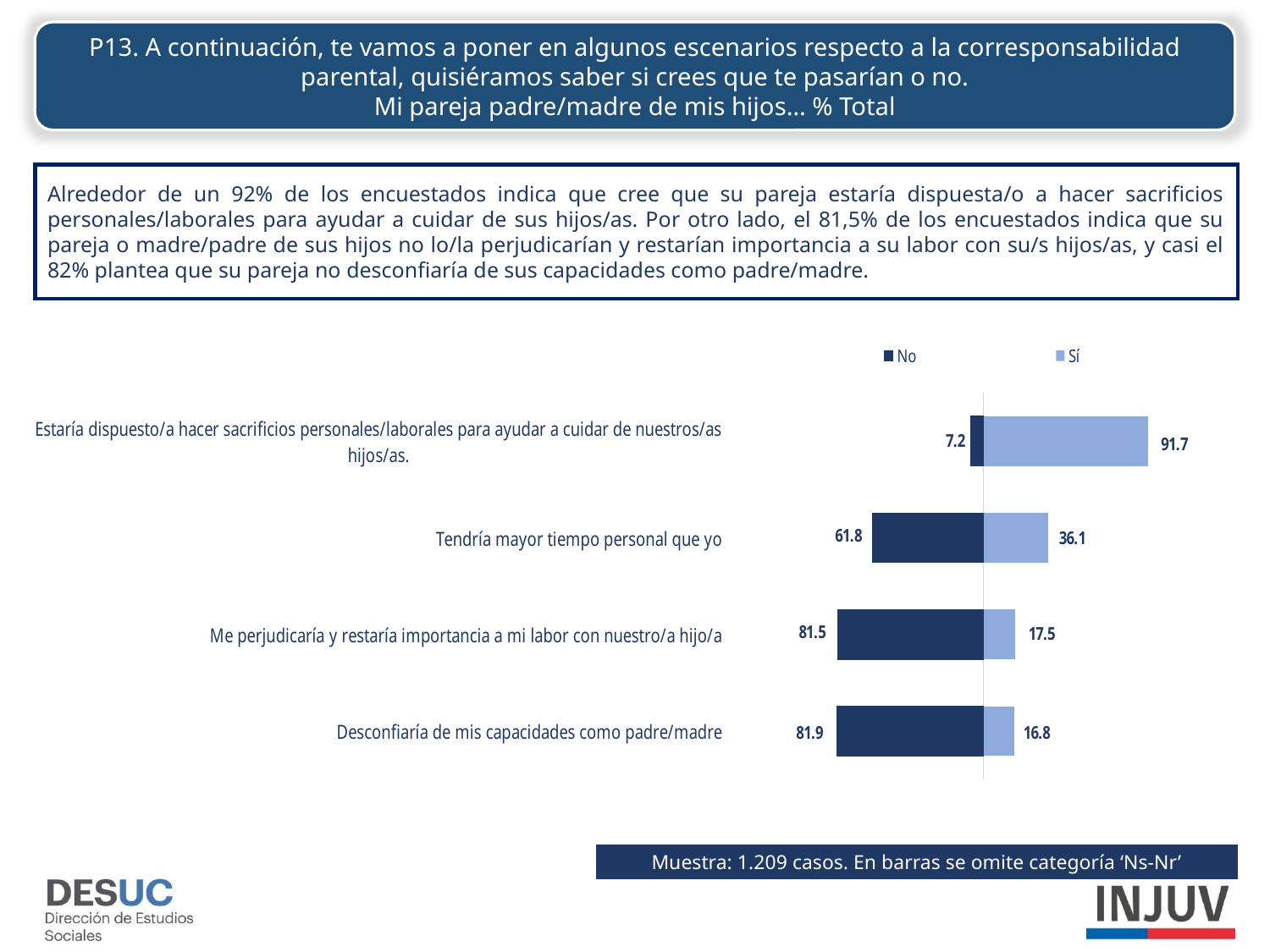
What is the difference between the 'Sí' and 'No' values for 'Estaría dispuesto/a hacer sacrificios personales/laborales para ayudar a cuidar de nuestros/as hijos/as.'? 84.5 Which legend entry is shown in the darker blue colour? No What is the 'Sí' value for 'Me perjudicaría y restaría importancia a mi labor con nuestro/a hijo/a'? 17.5 What is the 'Sí' value for 'Estaría dispuesto/a hacer sacrificios personales/laborales para ayudar a cuidar de nuestros/as hijos/as.'? 91.7 Which statement has the highest 'Sí' value? Estaría dispuesto/a hacer sacrificios personales/laborales para ayudar a cuidar de nuestros/as hijos/as. How many series does the chart legend list? 2 What is the 'No' value for 'Desconfiaría de mis capacidades como padre/madre'? 81.9 Which statement has the lowest 'No' value? Estaría dispuesto/a hacer sacrificios personales/laborales para ayudar a cuidar de nuestros/as hijos/as. What is the 'No' value for 'Tendría mayor tiempo personal que yo'? 61.8 For 'Tendría mayor tiempo personal que yo', which is larger, the 'No' value or the 'Sí' value? No How many categories (statements) are plotted in the chart? 4 What kind of chart is shown on the slide? Bar chart